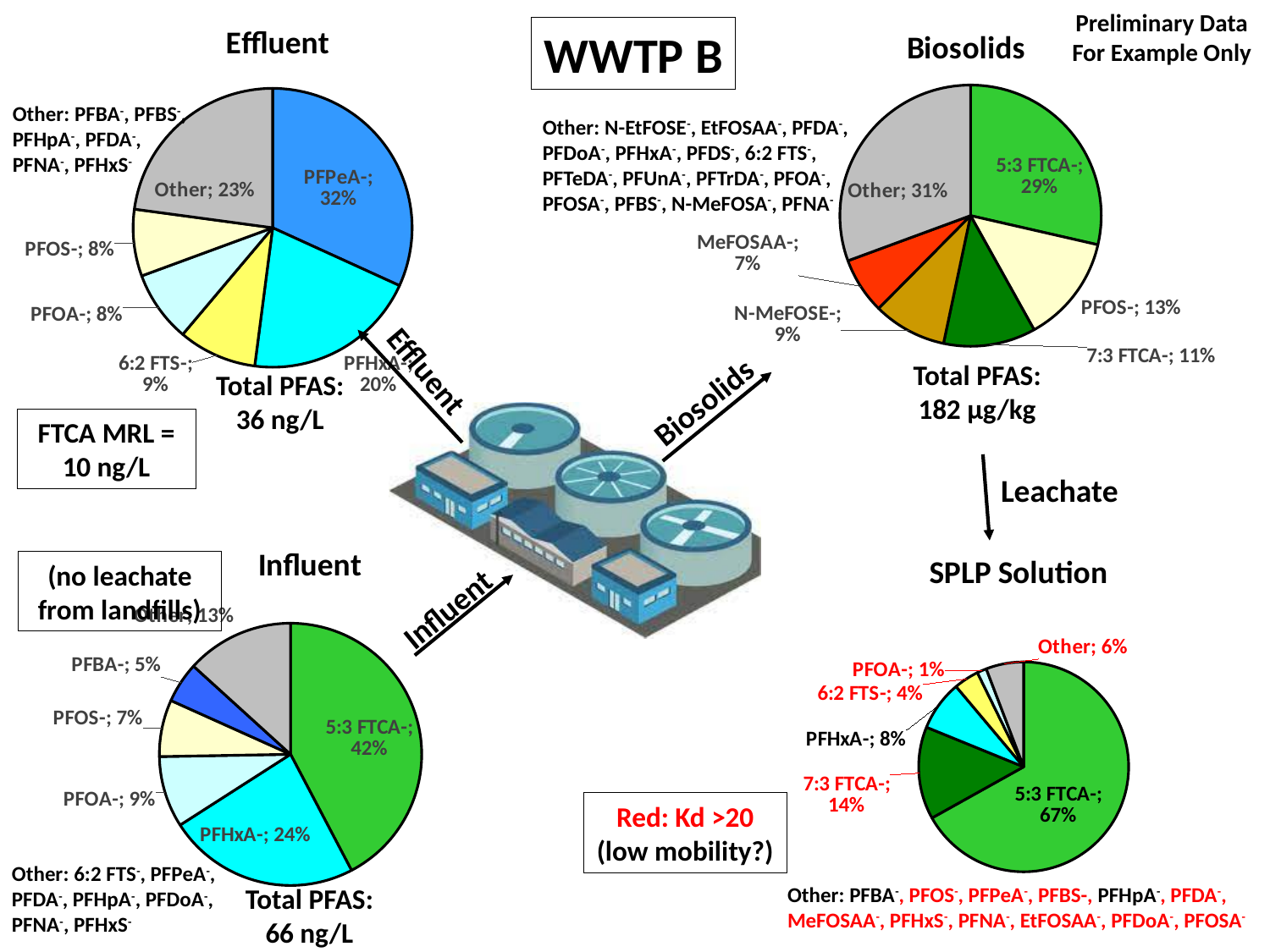
In the Effluent pie chart, which labelled slice is the largest? PFPeA- How many slices does the Influent pie chart have? 6 In the Effluent pie chart, what share does PFPeA- have? 32% In the SPLP Solution pie chart, what share does 5:3 FTCA- have? 67% In the SPLP Solution pie chart, what is the difference between the 7:3 FTCA- share and the PFHxA- share? 6% What type of chart is used for the Effluent data? Pie chart In the Biosolids pie chart, what share does PFOS- have? 13% In the Biosolids pie chart, which labelled slice is the smallest? MeFOSAA- What total PFAS value is shown under the Biosolids pie chart? 182 µg/kg In the Influent pie chart, which is larger, the PFOA- slice or the PFOS- slice? PFOA- In the Influent pie chart, what share does PFHxA- have? 24% In the Biosolids pie chart, what is the difference between the Other share and the 5:3 FTCA- share? 2%